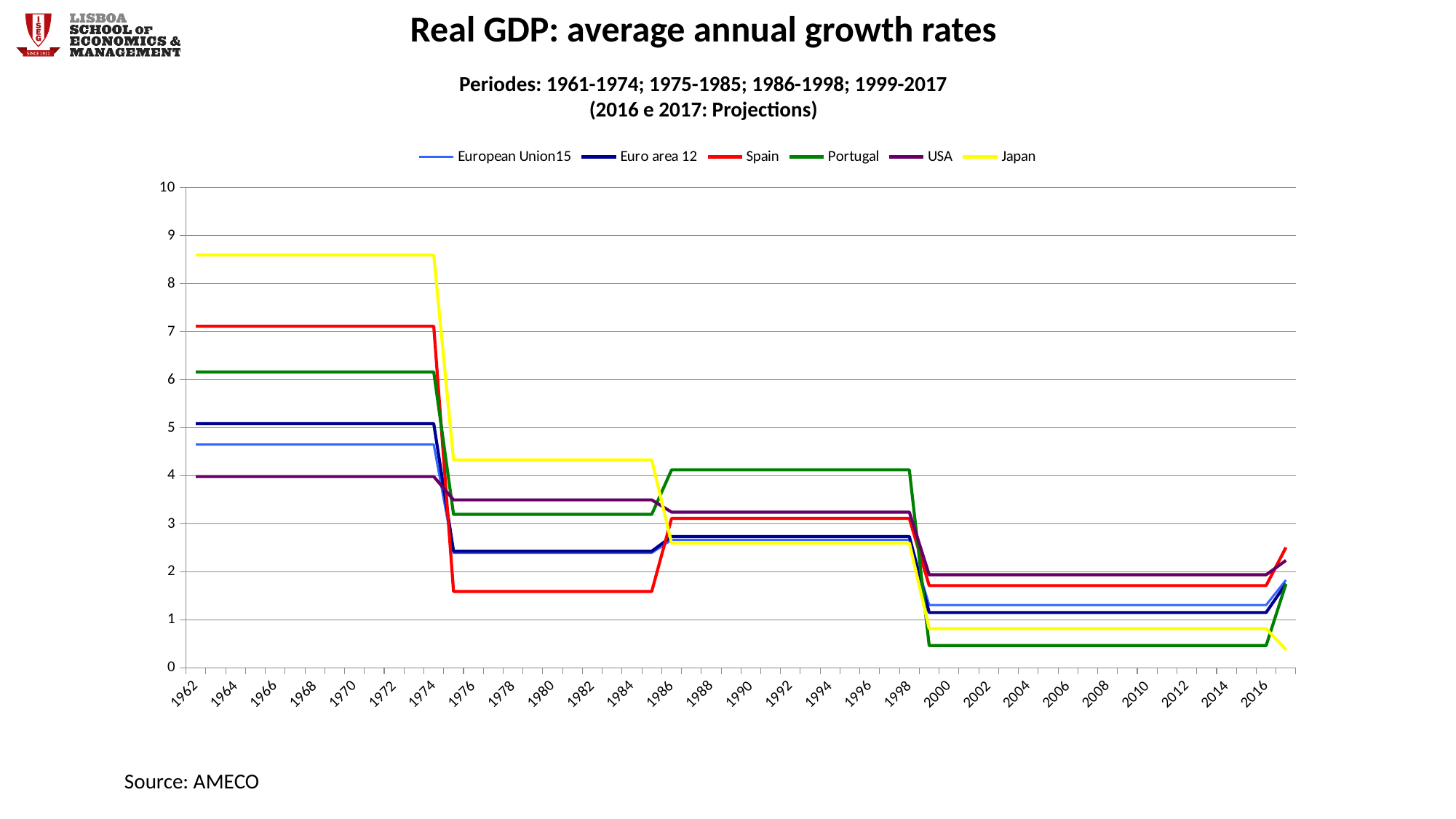
What is the title of the chart? Real GDP: average annual growth rates How many series does the legend list? 6 Is the value for Japan in 1970 greater or less than 8? greater Which series has the highest value in the 1961-1974 period? Japan Does the Japan line generally rise or fall from left to right along the x axis? fall Which is larger in 1970, the value for Spain or the value for Portugal? Spain Which series has the lowest value in the 1961-1974 period? USA Which series has the lowest value in the 1999-2017 period (e.g. around 2005)? Portugal Is the value for Spain in 1980 greater or less than 2? less What kind of chart is shown on the slide? line chart Which series has the highest value in the 1986-1998 period? Portugal Which series is drawn in yellow? Japan